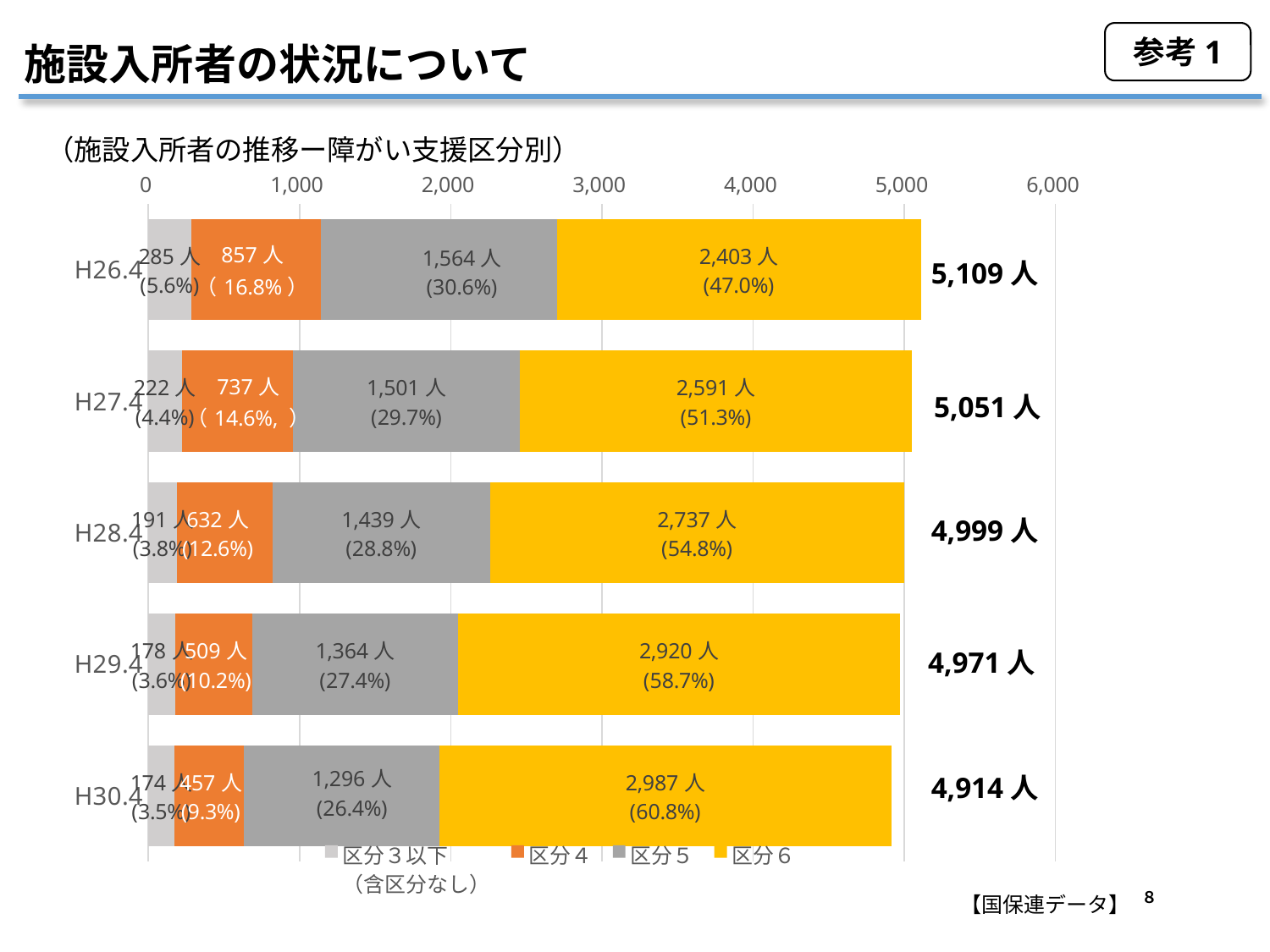
How many series does the legend list? 4 Which is larger, the 区分5 value in H29.4 or the 区分5 value in H30.4? H29.4 (1,364 人) What type of chart is shown on the slide? Stacked bar chart What is the difference between the 区分6 values for H30.4 and H26.4? 584 人 What is the value for 区分4 in H26.4? 857 人 How many time points (categories) are plotted on the chart? 5 What is the value for 区分5 in H28.4? 1,439 人 What is the value for 区分6 in H30.4? 2,987 人 Do the 区分6 values rise or fall from H26.4 to H30.4? Rise Which year has the lowest total number of facility residents? H30.4 Which year has the highest total number of facility residents? H26.4 What is the total of the stacked bar for H27.4? 5,051 人